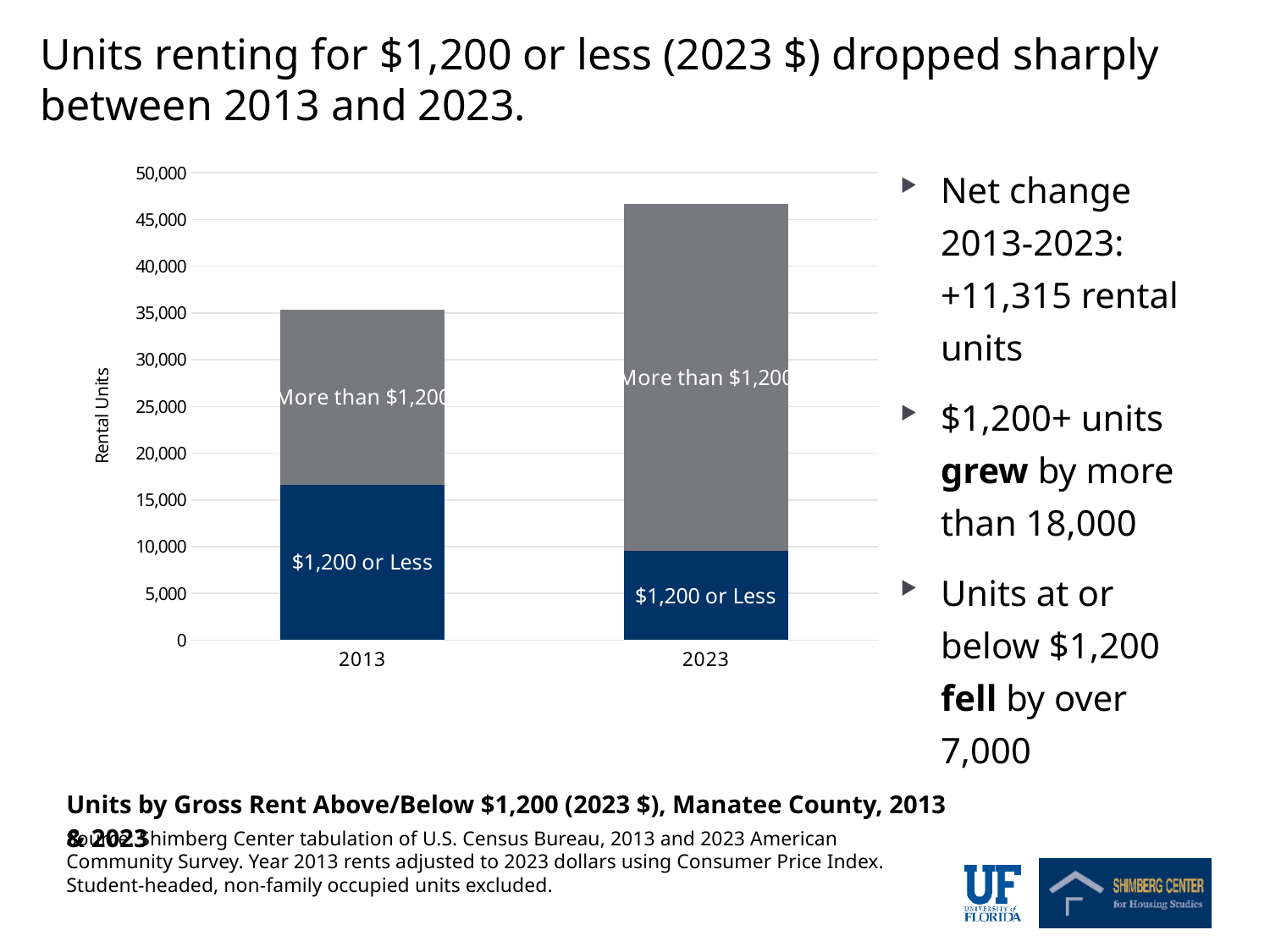
Is the total number of rental units in 2013 greater or less than 30,000? greater What is the label on the vertical axis of the chart? Rental Units Which year has the taller total bar, 2013 or 2023? 2023 Is the '$1,200 or Less' segment for 2013 greater or less than 15,000? greater Which year has the larger '$1,200 or Less' segment, 2013 or 2023? 2013 How many rent segments (series) are stacked in each bar? 2 Does the total number of rental units rise or fall from 2013 to 2023? rise Is the total number of rental units in 2023 greater or less than 45,000? greater Which year has the larger 'More than $1,200' segment, 2013 or 2023? 2023 What kind of chart is shown on the slide? Stacked bar chart How many years (categories) are shown on the x axis of the chart? 2